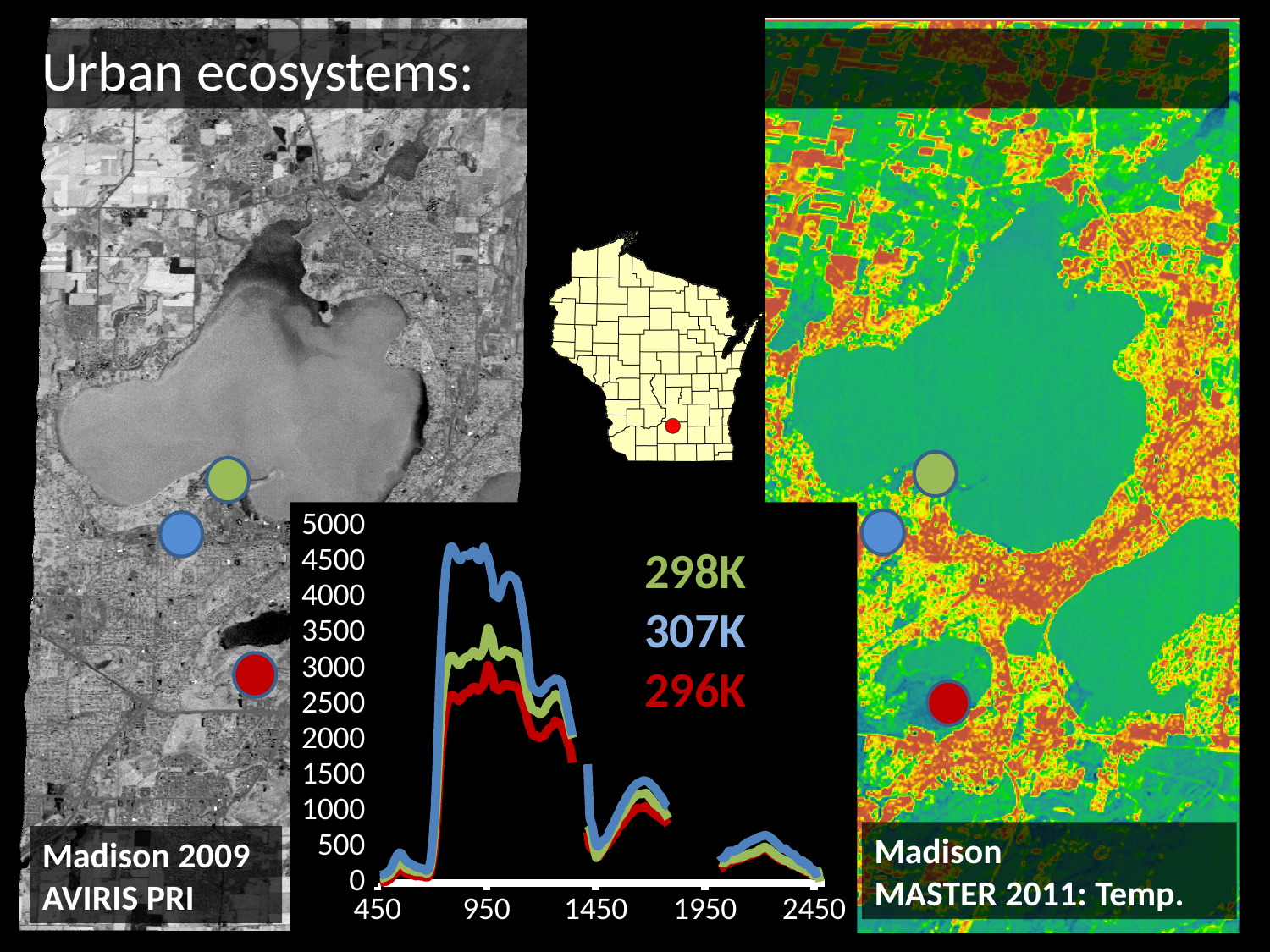
What kind of chart is shown at the bottom centre of the slide? line chart Is the peak value of the blue line greater or less than 4500? greater Which temperature label on the chart is printed in blue? 307K Which coloured line has the lowest peak on the chart? red What is the first tick value shown on the chart's x axis? 450 What is the highest tick value shown on the chart's y axis? 5000 Which line is higher around 950 on the x axis, the blue line or the green line? blue How many lines are plotted on the chart? 3 Which coloured line reaches the highest value on the chart? blue Is the peak value of the red line greater or less than 3500? less